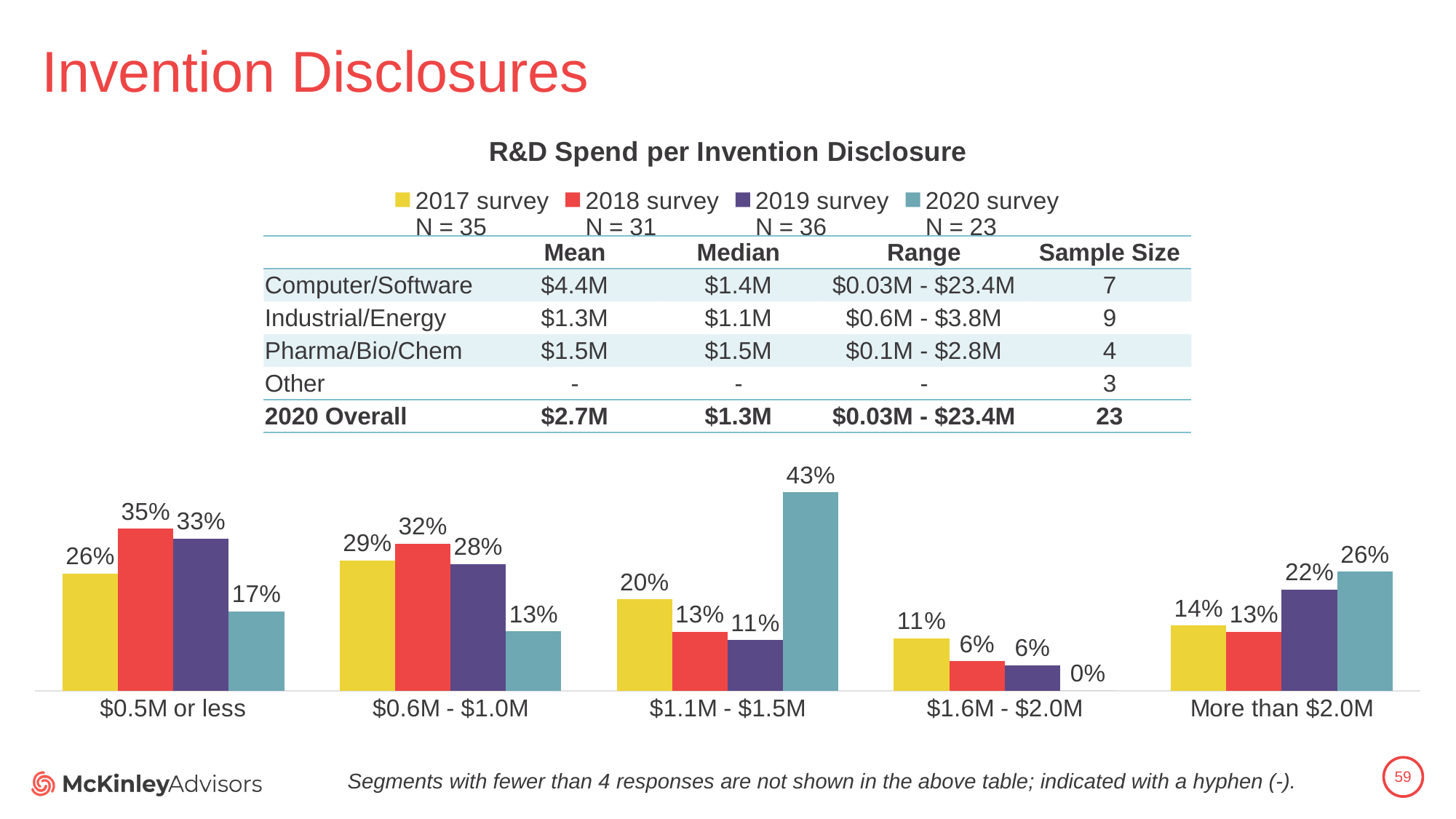
What is the difference between the 2020 survey and 2019 survey values for the $1.1M - $1.5M category? 32% How many series does the chart legend list? 4 What kind of chart is shown on the slide? Bar chart What is the title of the chart? R&D Spend per Invention Disclosure What is the 2018 survey value for the $0.5M or less category? 35% Which category has the lowest 2017 survey value? $1.6M - $2.0M What is the 2019 survey value for the More than $2.0M category? 22% What is the 2020 survey value for the $1.1M - $1.5M category? 43% Which is larger for the $0.6M - $1.0M category: the 2017 survey value or the 2018 survey value? 2018 survey What is the sample size (N) for the 2020 survey shown in the legend? N = 23 How many spend categories are shown on the x axis of the chart? 5 Which category has the highest 2020 survey value? $1.1M - $1.5M